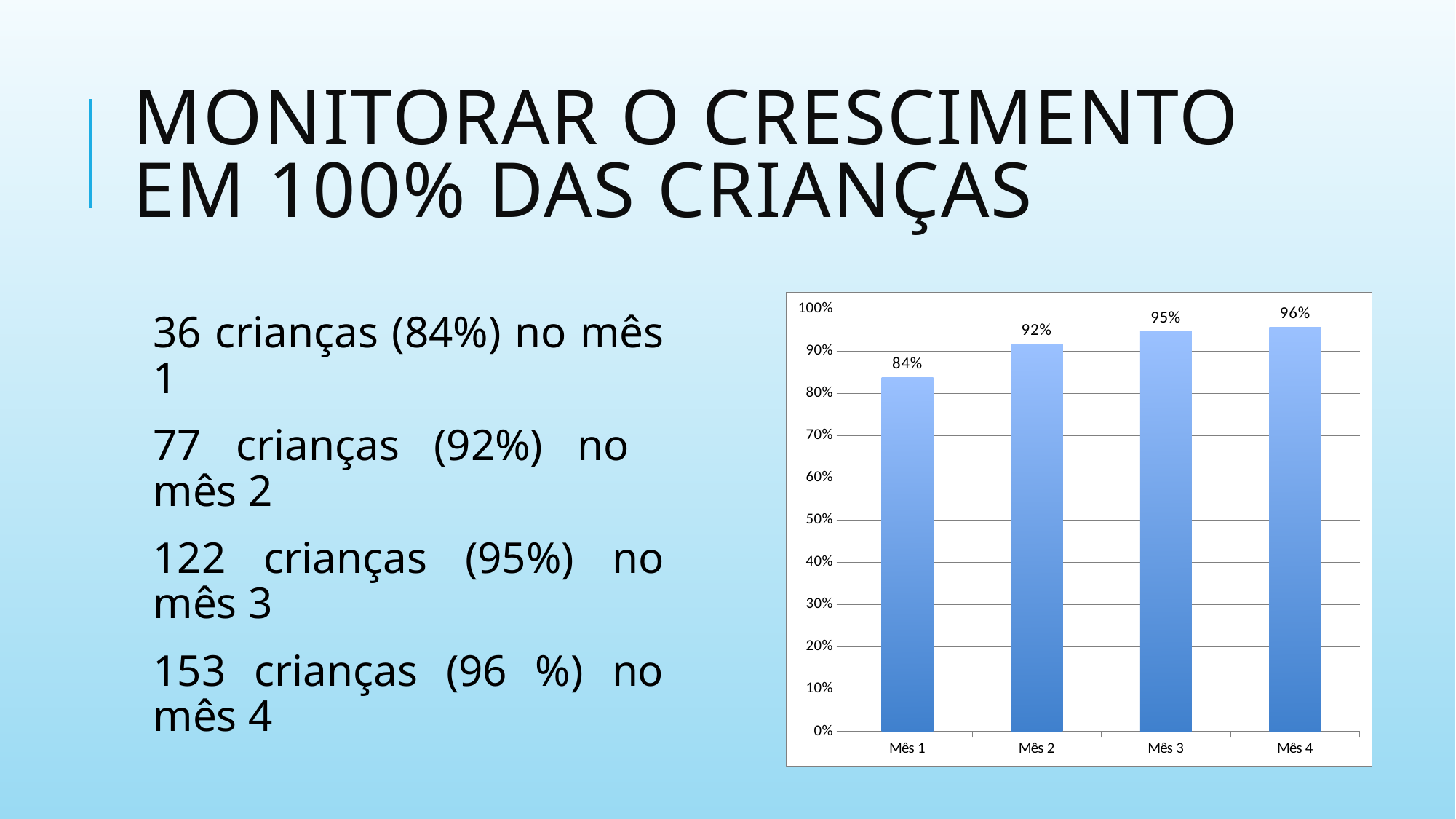
How many months are shown on the x axis? 4 Which is larger, the value for Mês 2 or the value for Mês 3? Mês 3 What kind of chart is shown on the slide? bar chart What is the value for Mês 4? 96% Which month has the lowest value? Mês 1 Is the value for Mês 1 greater or less than 90%? less Do the values rise or fall from Mês 1 to Mês 4? rise What is the value for Mês 1? 84% What is the value for Mês 3? 95% What is the difference between the values for Mês 2 and Mês 1? 8% Which month has the highest value? Mês 4 What is the difference between the values for Mês 4 and Mês 3? 1%